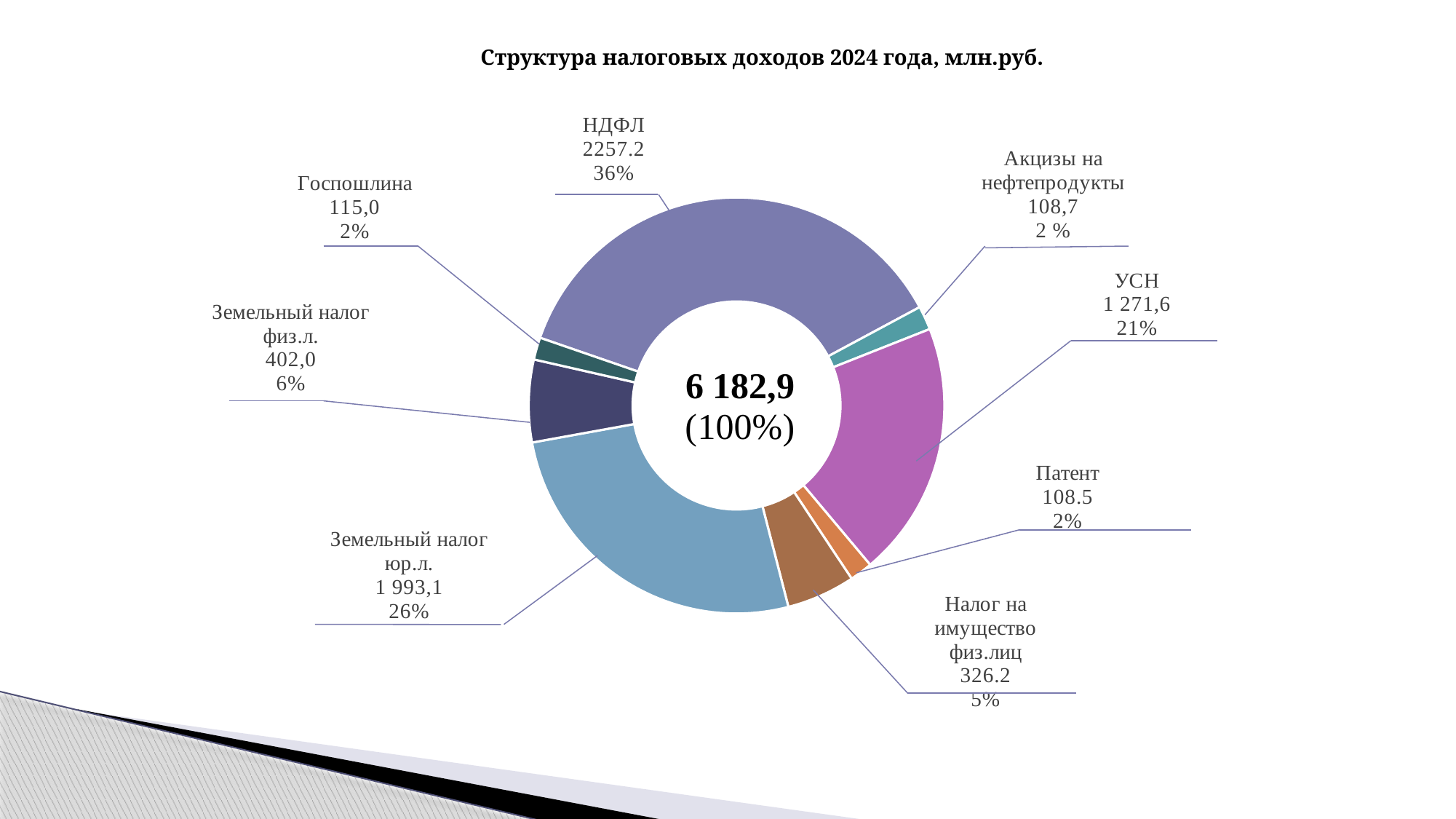
What is the value for Налог на имущество физ.лиц? 326.2 Which category has the largest slice? НДФЛ Which is larger, Земельный налог физ.л. or Госпошлина? Земельный налог физ.л. What share of the total does Земельный налог юр.л. represent? 26% What total value is shown in the centre of the chart? 6 182,9 What is the value for УСН? 1 271,6 What is the difference between the values for НДФЛ and Земельный налог юр.л.? 264,1 What kind of chart is shown on the slide? Doughnut (pie) chart What is the value for НДФЛ? 2257.2 What share of the total does УСН represent? 21% How many categories are shown in the chart? 8 What is the value for Земельный налог юр.л.? 1 993,1